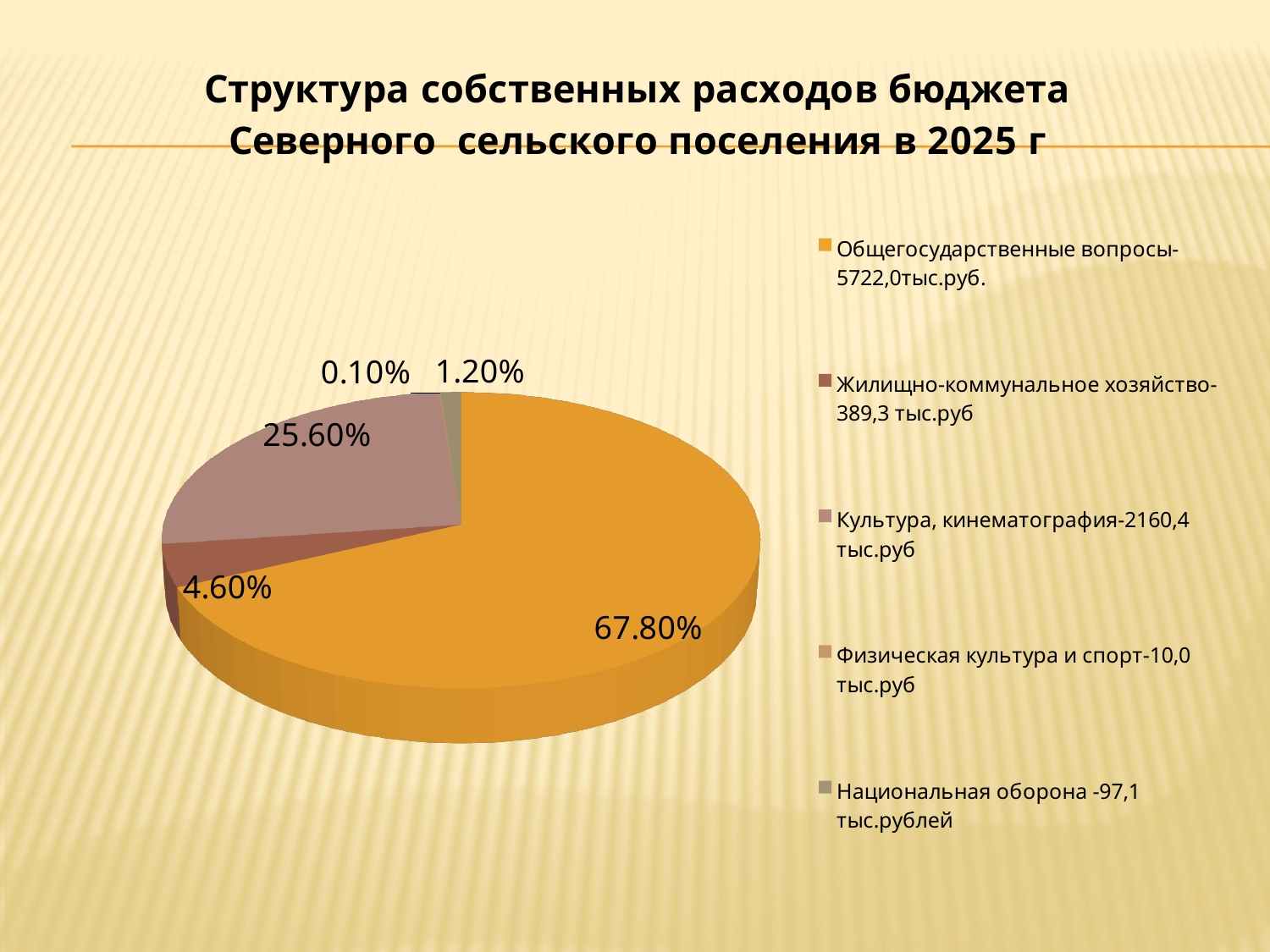
What share of the pie does Общегосударственные вопросы have? 67.80% What amount in тыс.руб. does the legend give for Культура, кинематография? 2160,4 тыс.руб What is the difference in percentage points between the Общегосударственные вопросы slice and the Культура, кинематография slice? 42.20% What share of the pie does Жилищно-коммунальное хозяйство have? 4.60% Which slice is larger: Жилищно-коммунальное хозяйство or Национальная оборона? Жилищно-коммунальное хозяйство What share of the pie does Национальная оборона have? 1.20% What type of chart is shown on the slide? pie chart Which category has the largest slice of the pie? Общегосударственные вопросы What share of the pie does Физическая культура и спорт have? 0.10% What share of the pie does Культура, кинематография have? 25.60% How many categories does the pie chart show? 5 Which category has the smallest slice of the pie? Физическая культура и спорт